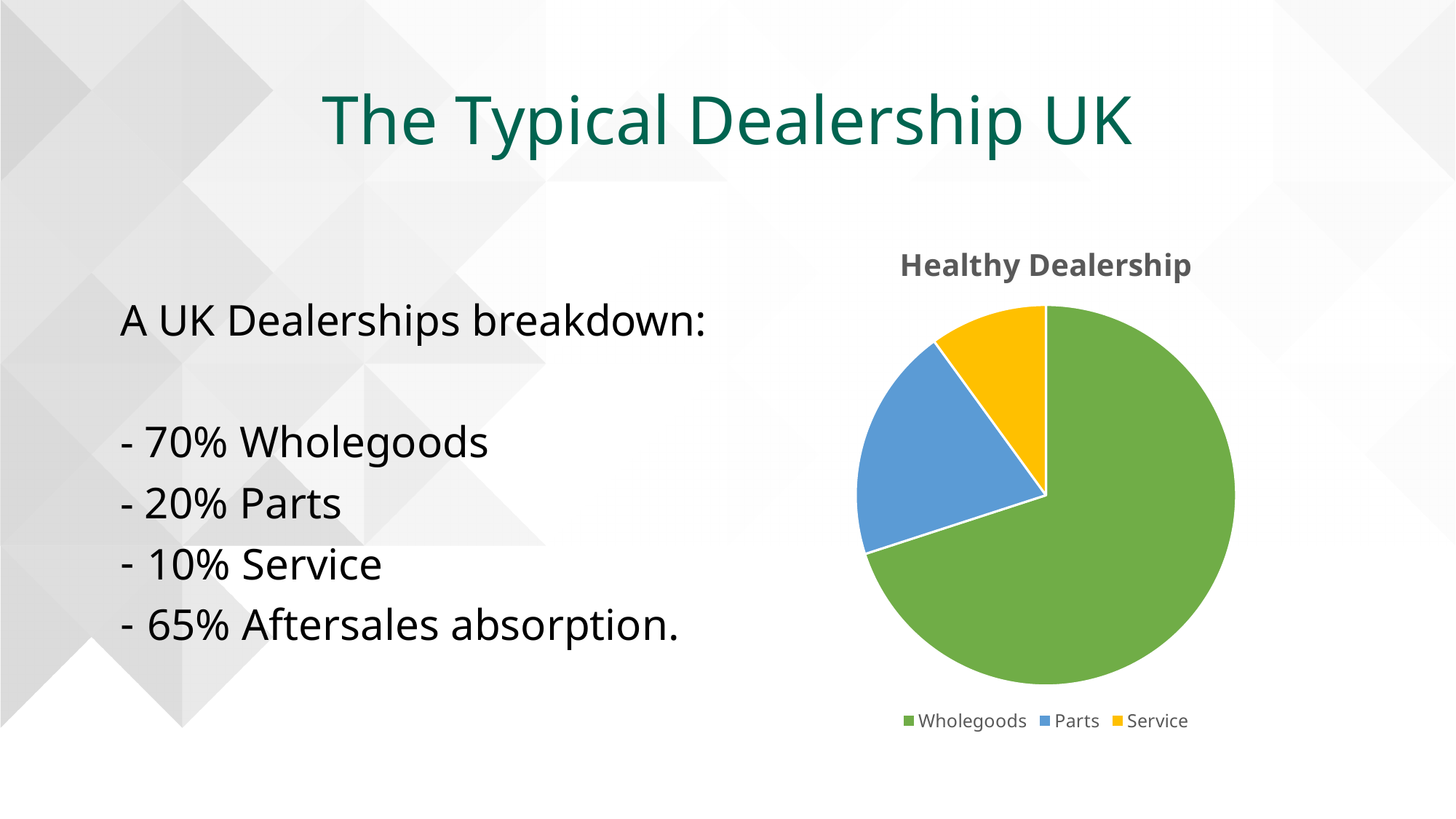
Which slice is larger, Wholegoods or Parts? Wholegoods What share of the pie does Parts represent, according to the slide? 20% Which category has the largest slice of the pie? Wholegoods What kind of chart is shown on the slide? pie chart What share of the pie does Wholegoods represent, according to the slide? 70% What colour is the Wholegoods slice in the pie chart? green How many slices does the pie chart have? 3 What is the title of the chart? Healthy Dealership What share of the pie does Service represent, according to the slide? 10% Which slice is larger, Parts or Service? Parts How many entries does the chart legend list? 3 Which category has the smallest slice of the pie? Service